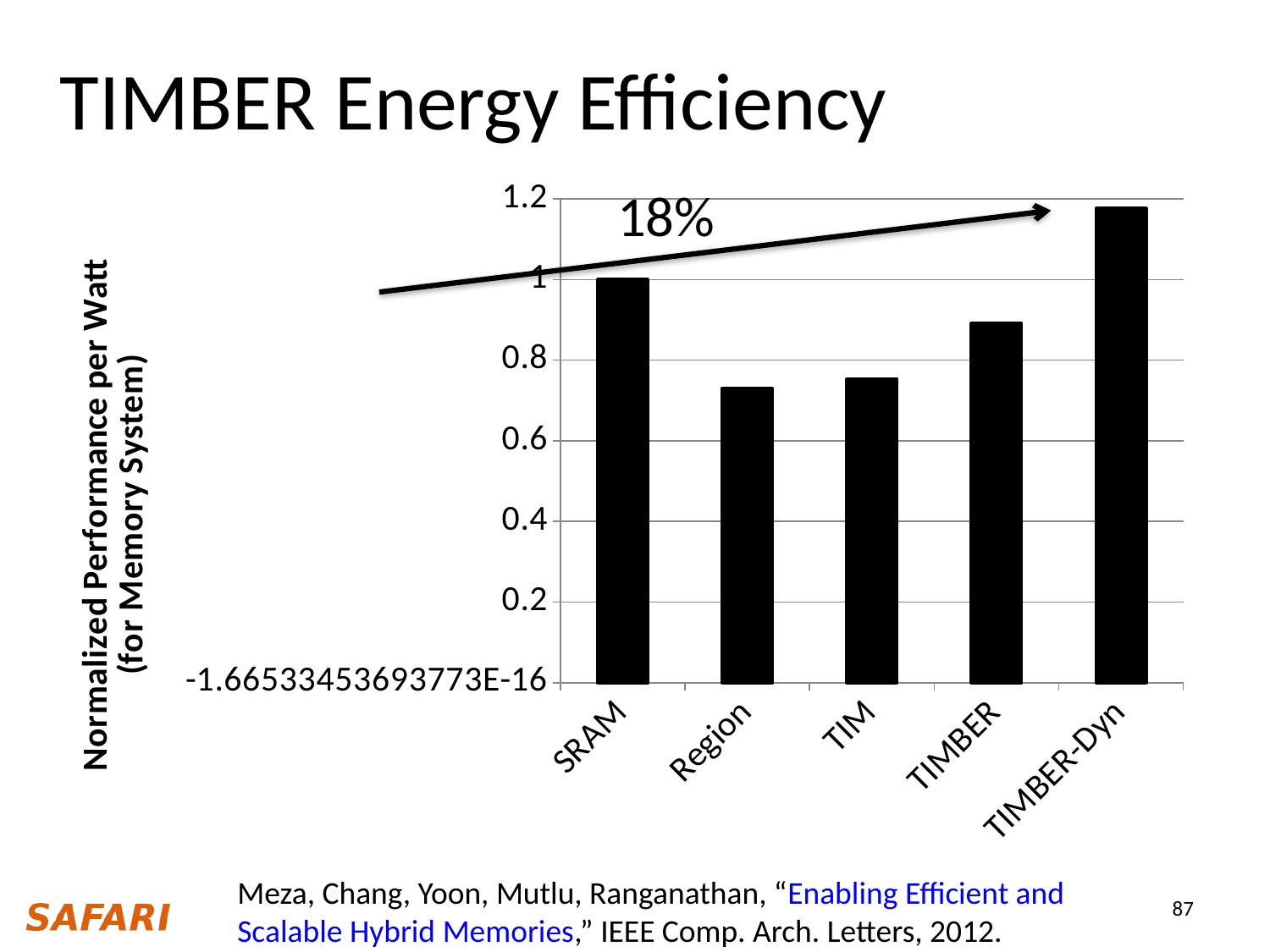
What is the label of the y axis of the chart? Normalized Performance per Watt (for Memory System) Is the value for TIM greater or less than 0.8? less Is the value for TIMBER-Dyn greater or less than 1? greater Is the value for Region greater or less than 0.8? less What is the normalized performance per watt for SRAM? 1 Which has a larger normalized performance per watt, SRAM or TIMBER? SRAM What percentage is written next to the arrow annotation on the chart? 18% Which category has the highest normalized performance per watt? TIMBER-Dyn Which has a larger normalized performance per watt, TIM or TIMBER? TIMBER What kind of chart is shown on the slide? bar chart How many categories are plotted on the x axis of the chart? 5